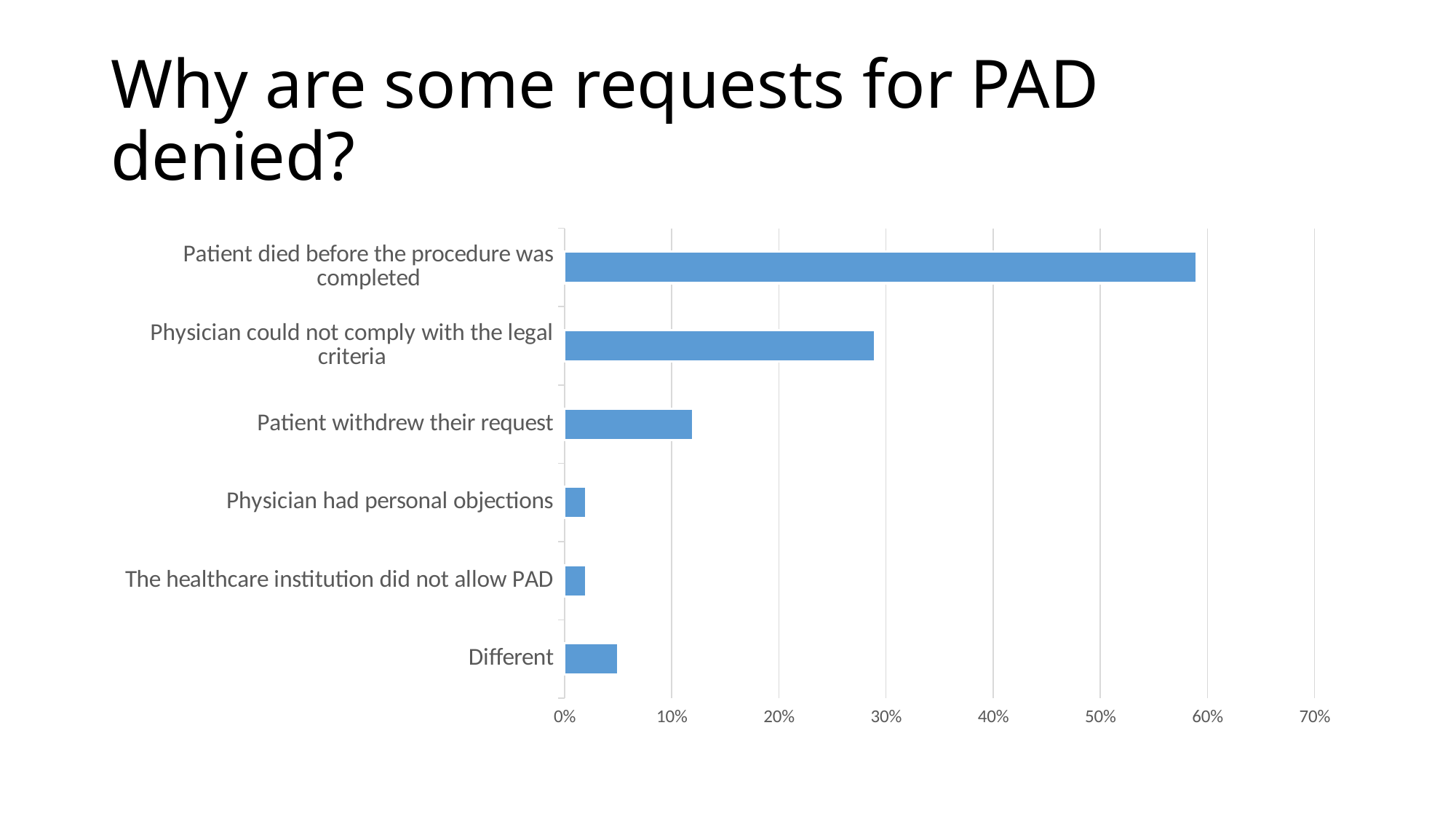
How many categories (reasons) are shown in the chart? 6 Is the value for 'Patient withdrew their request' greater or less than 10%? greater Which reason has the highest value in the chart? Patient died before the procedure was completed Is the value for 'Physician could not comply with the legal criteria' greater or less than 20%? greater Is the value for 'Patient died before the procedure was completed' greater or less than 60%? less What kind of chart is shown on the slide? bar chart What is the title of the slide containing the chart? Why are some requests for PAD denied? Which is larger: the value for 'Patient withdrew their request' or the value for 'Different'? Patient withdrew their request Which is larger: the value for 'Physician could not comply with the legal criteria' or the value for 'Physician had personal objections'? Physician could not comply with the legal criteria